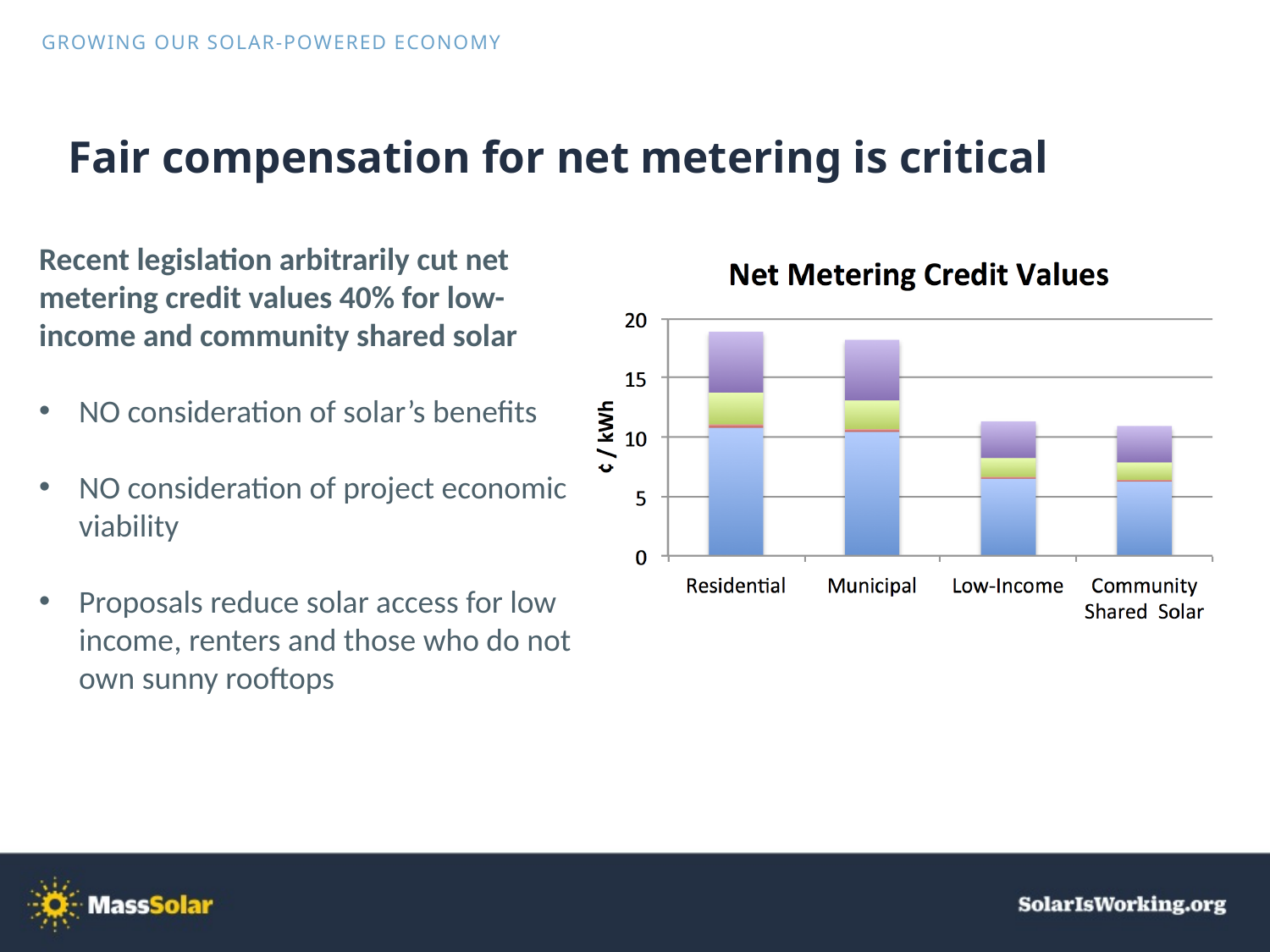
Is the total value for Community Shared Solar greater or less than 10? greater Is the total value for Residential greater or less than 15? greater Do the total bar values generally rise or fall moving from left to right across the categories? fall What is the title of the chart? Net Metering Credit Values Which has a larger total value, Residential or Low-Income? Residential How many categories are shown on the x axis of the chart? 4 Which category has the highest total net metering credit value? Residential Is the total value for Low-Income greater or less than 15? less What is the label on the vertical axis of the chart? ¢ / kWh What kind of chart is shown on the slide? bar chart Which has a larger total value, Municipal or Community Shared Solar? Municipal